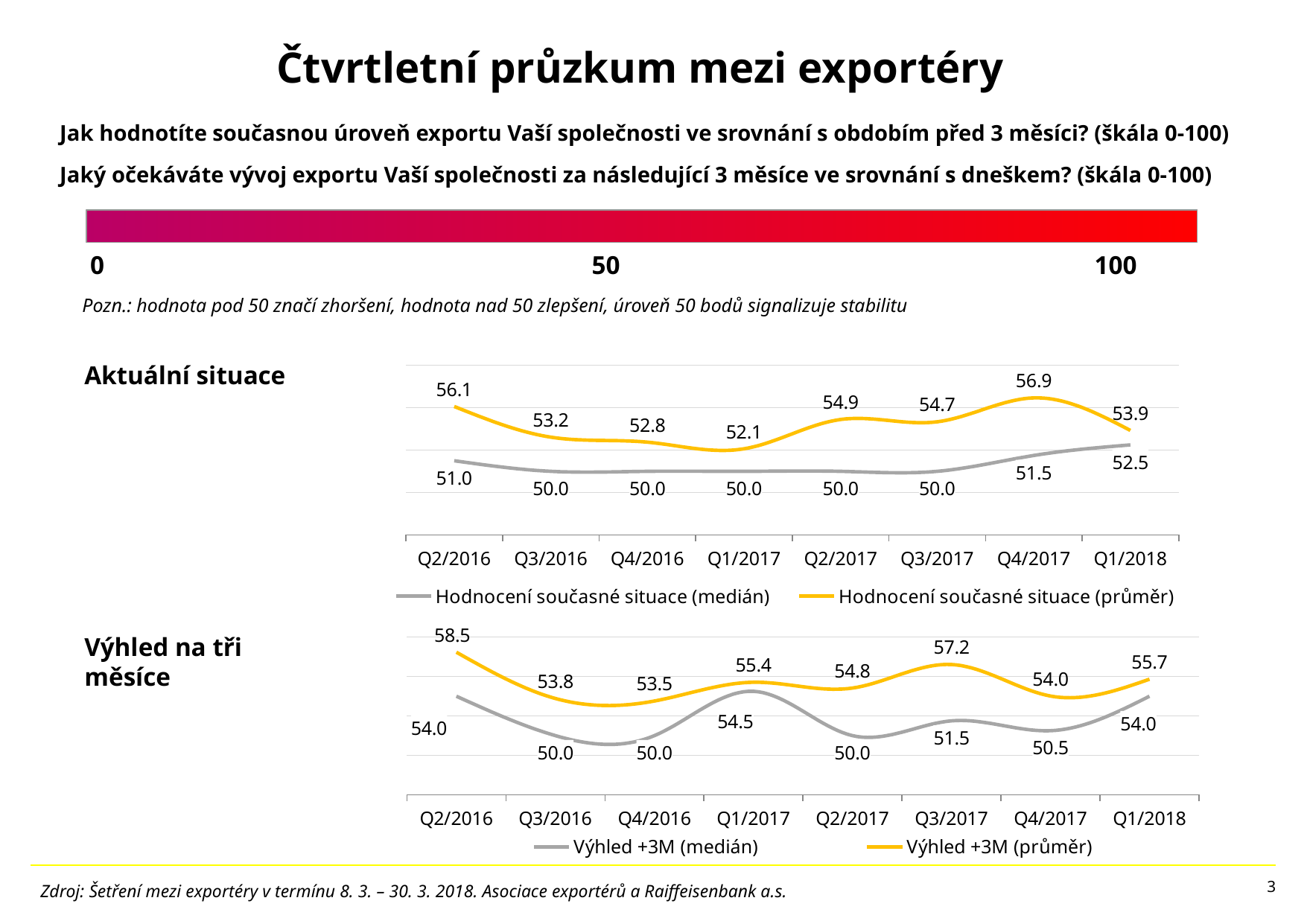
How many series does the legend of the 'Výhled na tři měsíce' chart list? 2 In the 'Aktuální situace' chart, what is the value of 'Hodnocení současné situace (průměr)' for Q4/2017? 56.9 In the 'Aktuální situace' chart, in which quarter is 'Hodnocení současné situace (průměr)' lowest? Q1/2017 In the 'Výhled na tři měsíce' chart, what is the difference between 'Výhled +3M (průměr)' in Q2/2016 and Q3/2016? 4.7 In the 'Aktuální situace' chart, what is the difference between the průměr and medián values for Q2/2016? 5.1 What type of chart is the 'Aktuální situace' chart? Line chart In the 'Výhled na tři měsíce' chart, in which quarter is 'Výhled +3M (průměr)' highest? Q2/2016 In the 'Výhled na tři měsíce' chart, what is the value of 'Výhled +3M (průměr)' for Q3/2017? 57.2 In the 'Aktuální situace' chart, how many quarters are shown on the x axis? 8 In the 'Aktuální situace' chart, what is the value of 'Hodnocení současné situace (medián)' for Q1/2018? 52.5 In the 'Výhled na tři měsíce' chart, which is larger for Q4/2017: 'Výhled +3M (průměr)' or 'Výhled +3M (medián)'? Výhled +3M (průměr) In the 'Výhled na tři měsíce' chart, what is the value of 'Výhled +3M (medián)' for Q1/2017? 54.5